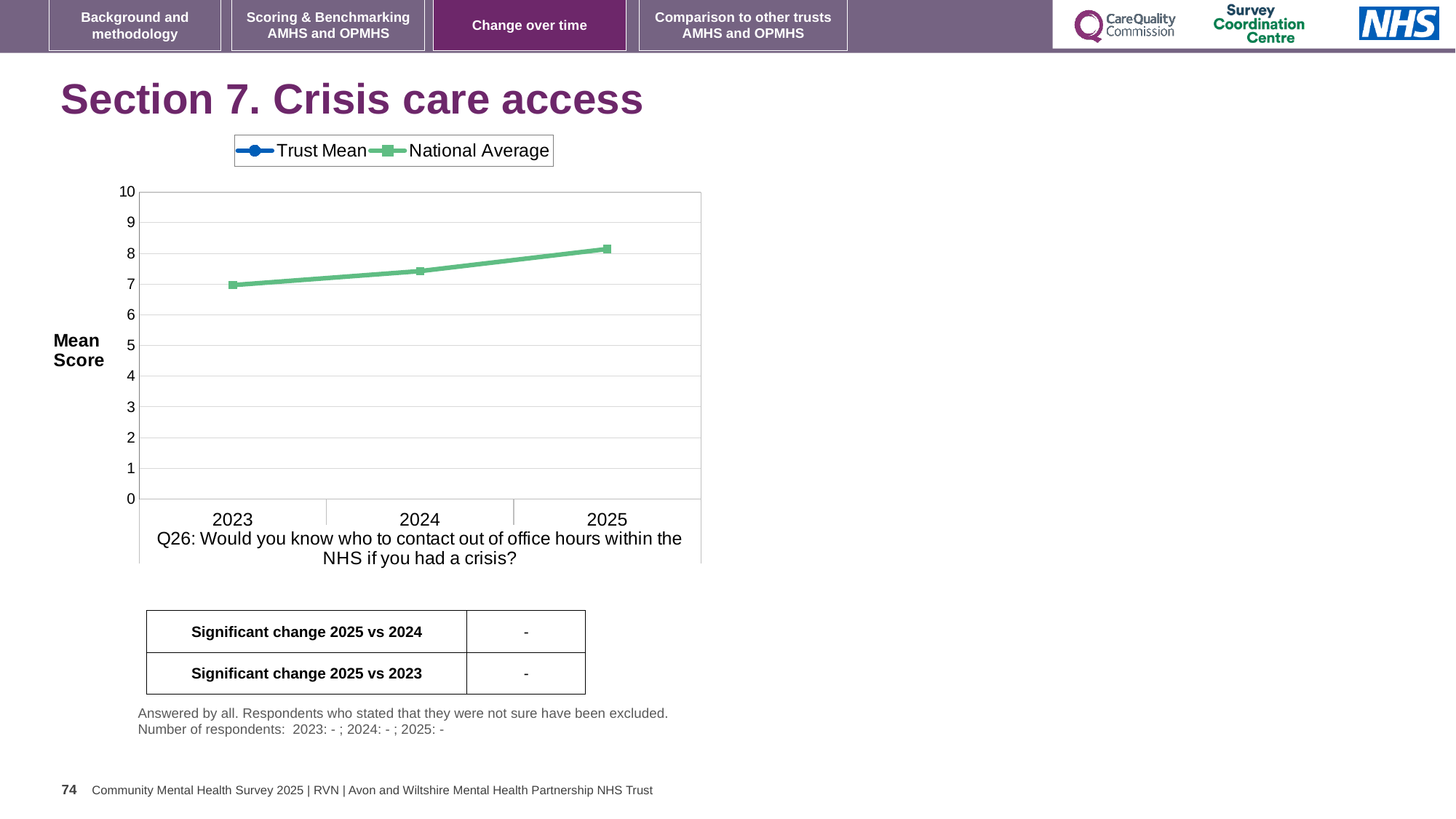
In which year is the National Average lowest? 2023 Is the National Average for 2025 greater or less than 7? greater Which is larger, the National Average for 2025 or for 2023? 2025 Is the National Average for 2024 greater or less than 9? less What kind of chart is shown on the slide? line chart What is the label on the y axis of the chart? Mean Score Does the National Average line rise or fall from 2023 to 2025? rise Is the National Average for 2023 greater or less than 8? less How many series does the chart legend list? 2 How many years are shown on the x axis of the chart? 3 What are the two series named in the chart legend? Trust Mean and National Average In which year is the National Average highest? 2025